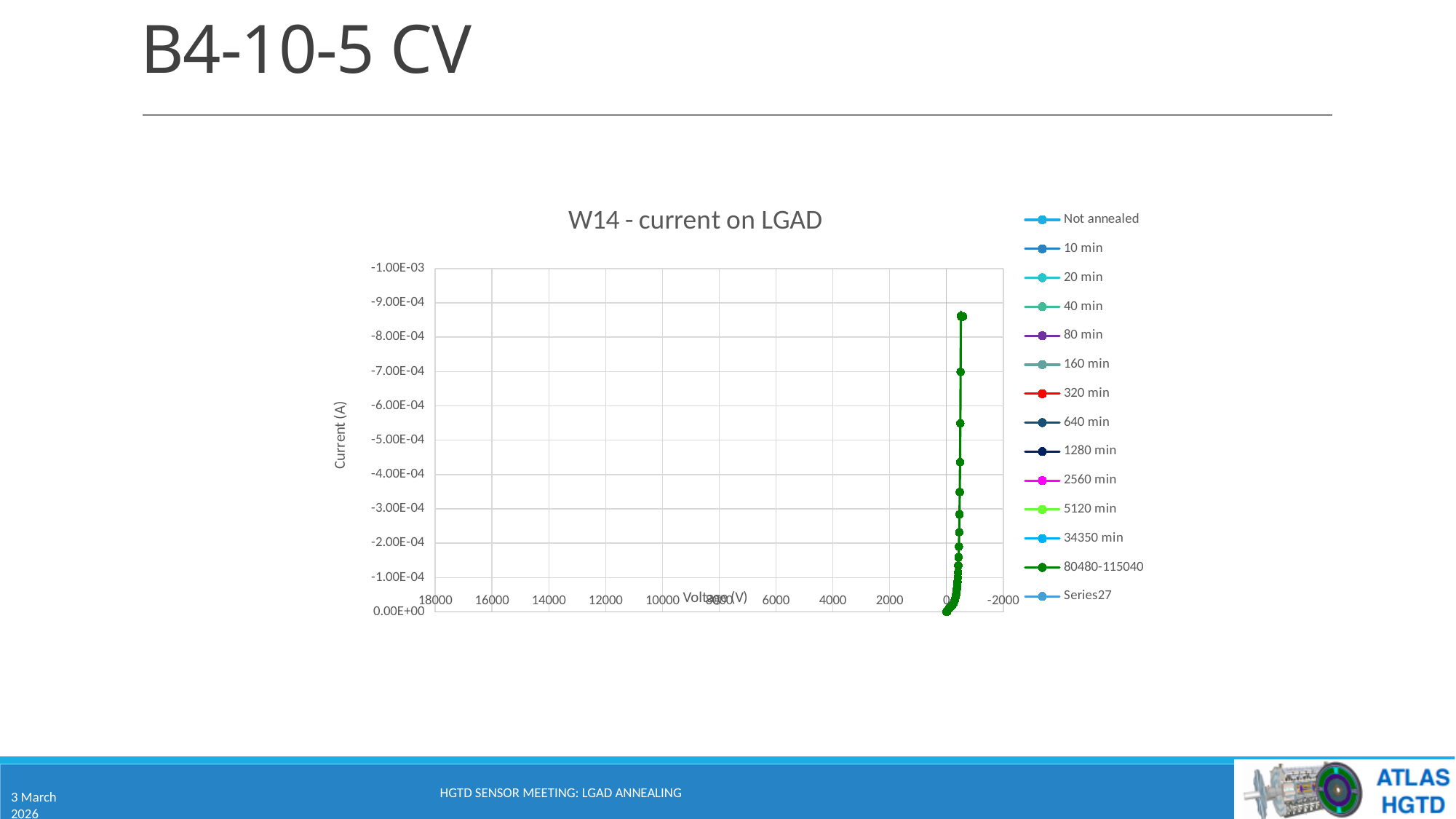
What kind of chart is shown on the slide? Line chart with markers What is the value at the top of the vertical axis of the chart? -1.00E-03 Does the plotted curve extend beyond -8.00E-04 on the current axis? Yes What is the last entry listed in the chart's legend? Series27 How many series does the chart's legend list? 14 Which legend series is the only one visibly plotted on the chart? 80480-115040 What is the label of the vertical axis of the chart? Current (A) What is the title of the chart on the slide? W14 - current on LGAD